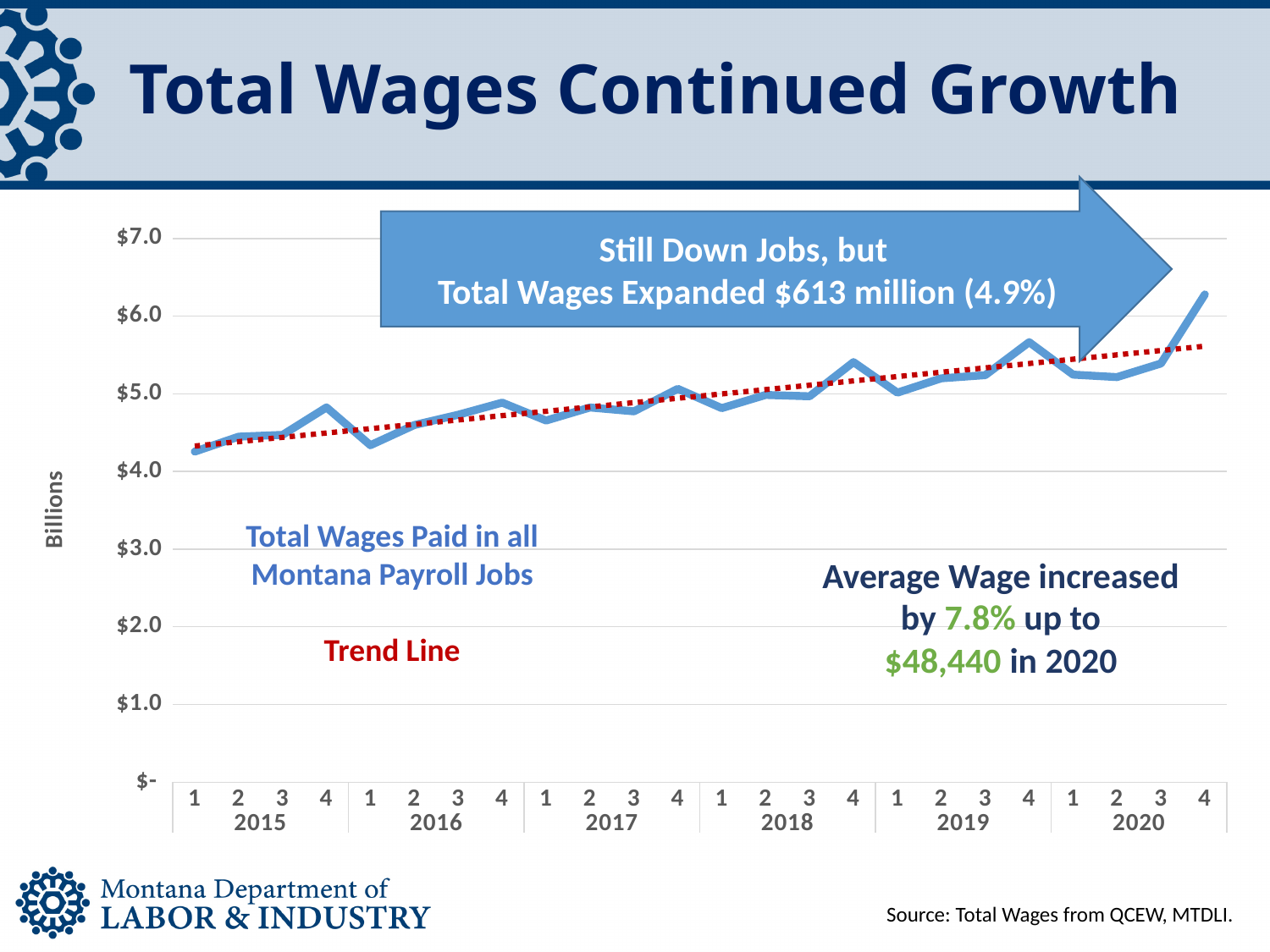
Do total wages generally rise or fall from 2015 to 2020 along the x axis? rise Is the value for Q1 2015 greater or less than $5.0 billion? less Is the value for Q4 2019 greater or less than $5.0 billion? greater Which is larger, total wages in Q4 2020 or in Q1 2015? Q4 2020 How many quarterly data points are plotted on the chart? 24 What kind of chart is shown on the slide? line chart What unit is shown on the y axis label of the chart? Billions Which quarter has the highest total wages on the chart? Q4 2020 How many years are labelled on the x axis of the chart? 6 What colour and style is the trend line on the chart? red dotted How many series are labelled on the chart? 2 Is the value for Q4 2020 greater or less than $6.0 billion? greater